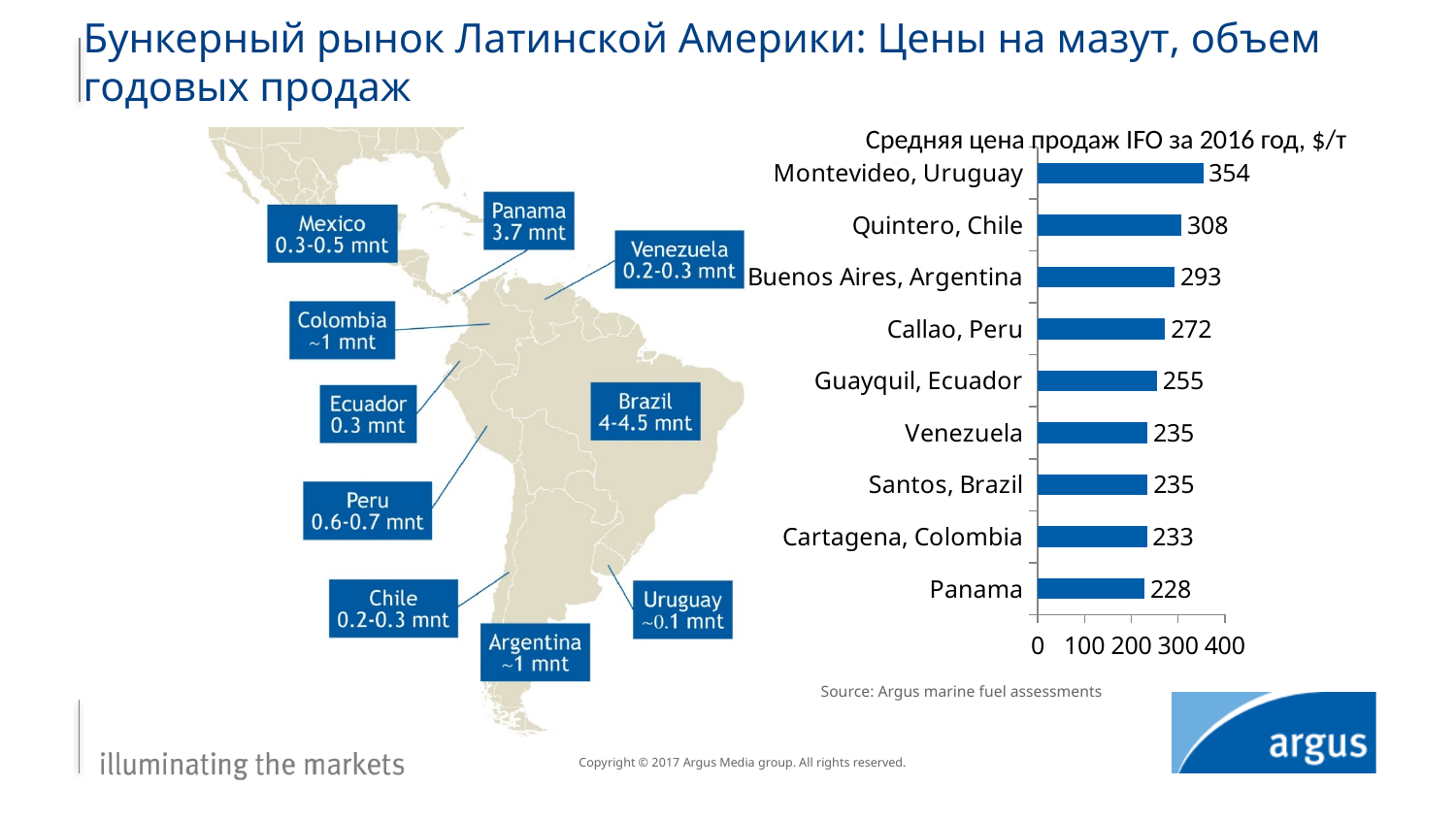
What is the average IFO sales price for Panama? 228 Is the IFO price for Quintero, Chile greater or less than 300? greater What type of chart is used to show the average IFO sales prices? Bar chart What is the average IFO sales price for Callao, Peru? 272 What is the difference between the IFO price for Montevideo, Uruguay and Quintero, Chile? 46 What is the average IFO sales price for Montevideo, Uruguay? 354 Which has a higher IFO price, Guayquil, Ecuador or Cartagena, Colombia? Guayquil, Ecuador How many ports are shown in the bar chart? 9 What is the difference between the IFO price for Buenos Aires, Argentina and Panama? 65 Which port has the highest average IFO sales price? Montevideo, Uruguay What is the title of the bar chart? Средняя цена продаж IFO за 2016 год, $/т Which port has the lowest average IFO sales price? Panama